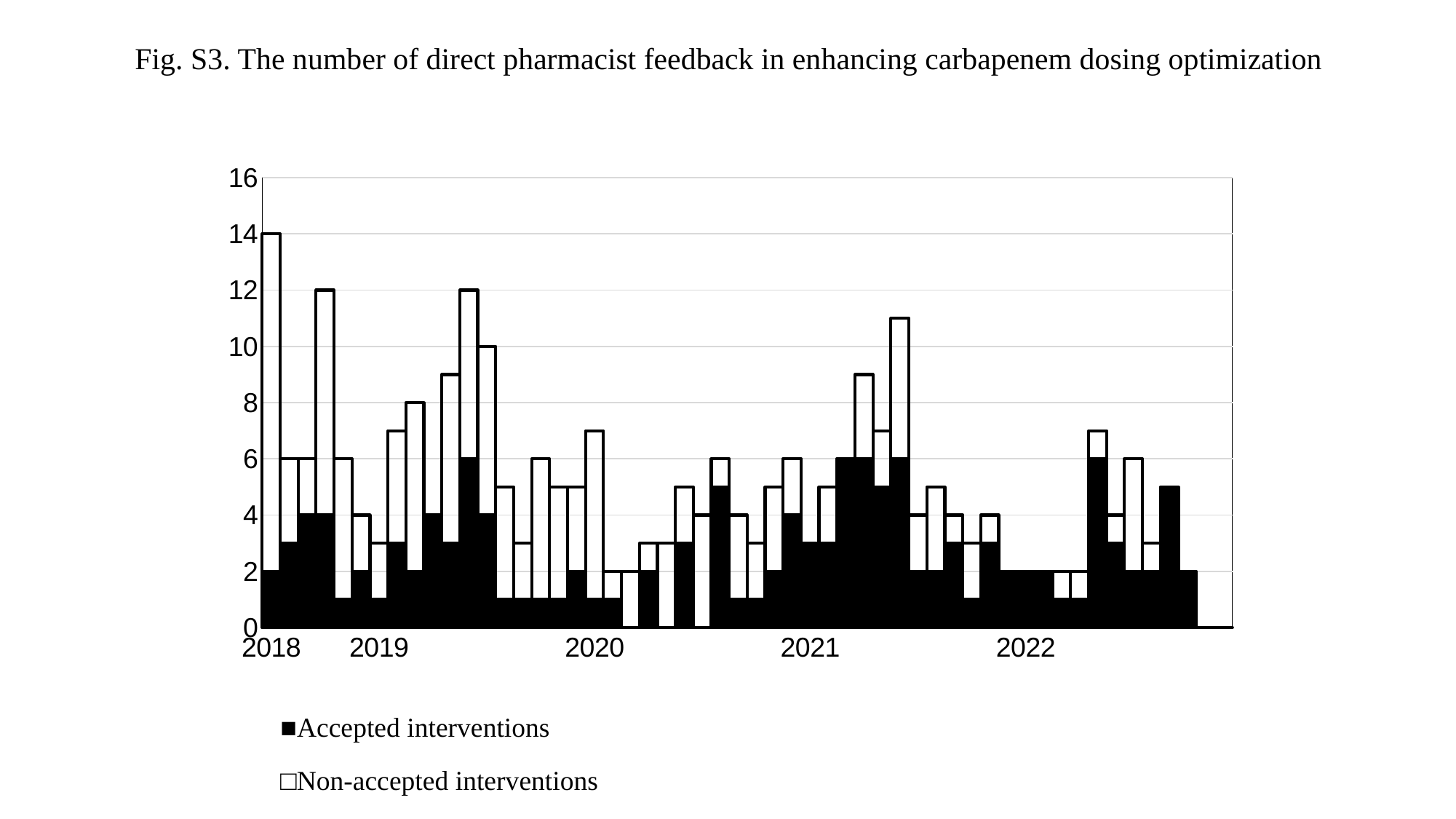
Is the total of the tallest bar in 2021 greater or less than 10? greater Is the total of the tallest bar greater or less than 12? greater What is the highest value shown on the y axis? 16 What kind of chart is shown on the slide? bar chart How many year labels are shown on the x axis? 5 Which series is drawn in solid black? Accepted interventions Is the total of the first bar at 2018 greater or less than 10? greater Which year label appears last on the x axis? 2022 How many series does the legend list? 2 What is the title of the chart? Fig. S3. The number of direct pharmacist feedback in enhancing carbapenem dosing optimization In which year does the tallest bar occur? 2018